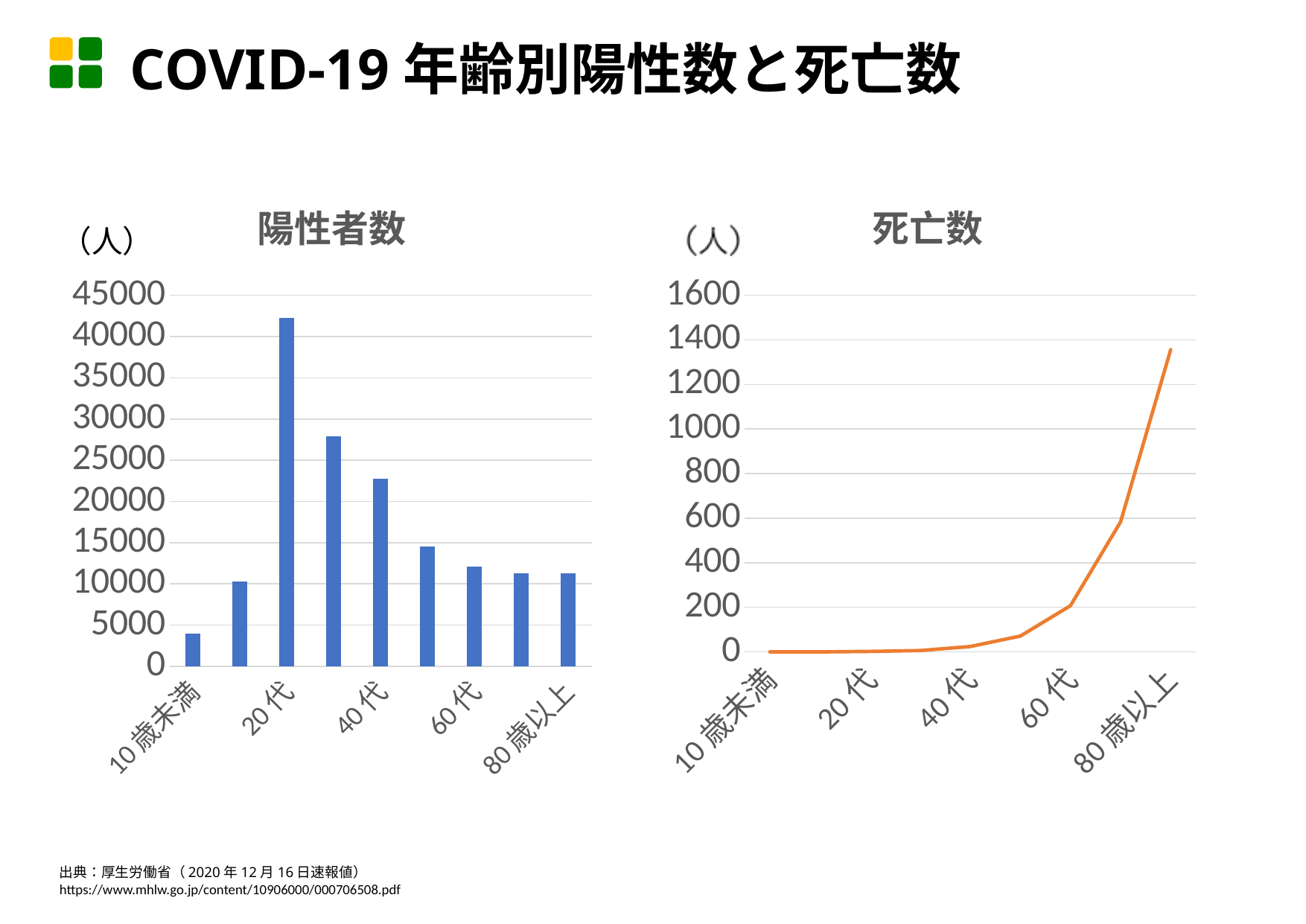
In the 死亡数 chart, is the value for 80歳以上 greater or less than 1200? greater What unit is shown in parentheses above the y axis of both charts? （人） In the 陽性者数 chart, is the value for 20代 greater or less than 40000? greater In the 陽性者数 chart, which age group has the highest number of positive cases? 20代 What kind of chart is the 死亡数 chart on the right? line chart How many bars are plotted in the 陽性者数 chart? 9 What kind of chart is the 陽性者数 chart on the left? bar chart In the 陽性者数 chart, which age group has the lowest number of positive cases? 10歳未満 In the 陽性者数 chart, is the value for 10歳未満 greater or less than 5000? less In the 陽性者数 chart, which is larger, the value for 20代 or the value for 40代? 20代 In the 死亡数 chart, do the values rise or fall from 10歳未満 to 80歳以上? rise